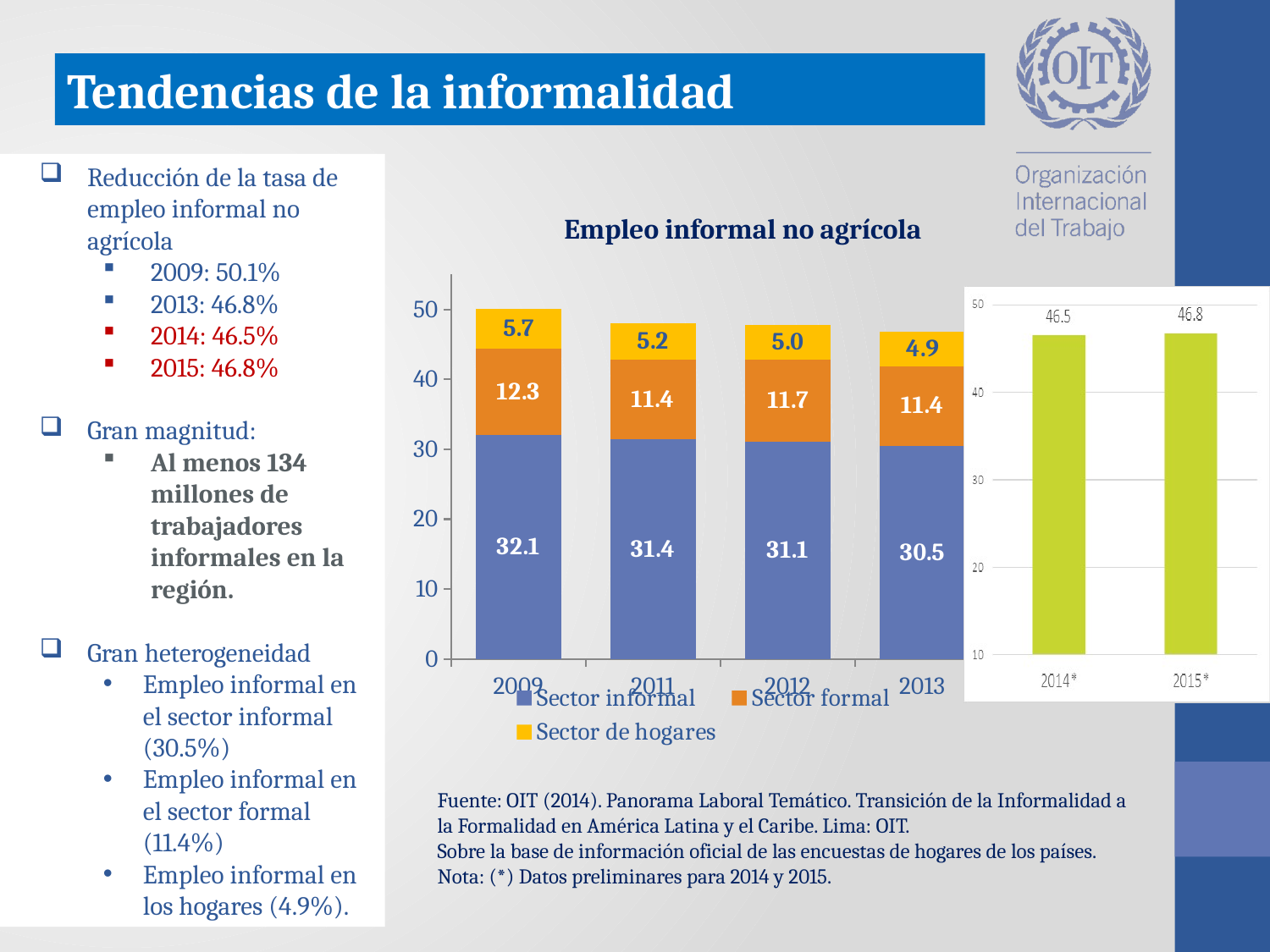
In the 'Empleo informal no agrícola' stacked bar chart, which year has the lowest Sector de hogares value? 2013 How many years are shown on the x axis of the 'Empleo informal no agrícola' stacked bar chart? 4 In the 'Empleo informal no agrícola' stacked bar chart, what is the value for Sector informal in 2009? 32.1 In the 'Empleo informal no agrícola' stacked bar chart, what is the difference between the Sector informal values for 2009 and 2013? 1.6 In the 'Empleo informal no agrícola' stacked bar chart, what is the value for Sector formal in 2012? 11.7 In the 'Empleo informal no agrícola' stacked bar chart, is the Sector formal value larger in 2012 or in 2013? 2012 In the small inset bar chart on the right, what is the value for 2015*? 46.8 In the 'Empleo informal no agrícola' stacked bar chart, what is the total of the stacked bar for 2009? 50.1 How many series does the legend of the 'Empleo informal no agrícola' stacked bar chart list? 3 In the 'Empleo informal no agrícola' stacked bar chart, which year has the highest Sector informal value? 2009 In the small inset bar chart on the right, is the value for 2014* greater or less than 40? greater In the 'Empleo informal no agrícola' stacked bar chart, what is the value for Sector de hogares in 2013? 4.9